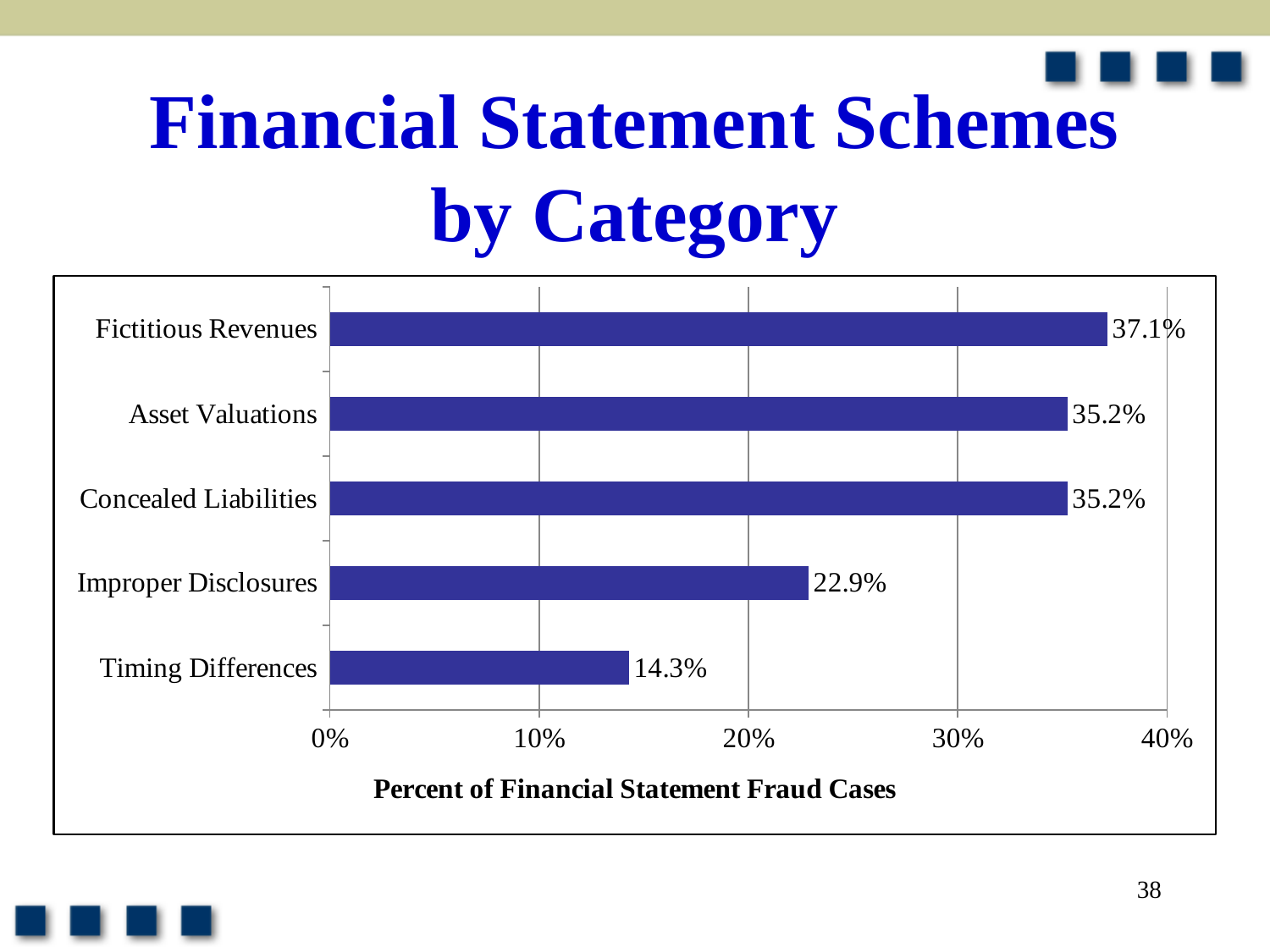
What is the difference between the values for Asset Valuations and Improper Disclosures? 12.3% Which is larger, the value for Improper Disclosures or the value for Timing Differences? Improper Disclosures How many categories are shown in the chart? 5 What percentage of financial statement fraud cases involved Fictitious Revenues? 37.1% What kind of chart is shown on the slide? Bar chart Which category has the highest percentage of financial statement fraud cases? Fictitious Revenues What is the value shown for Concealed Liabilities? 35.2% What is the value shown for Timing Differences? 14.3% Which category has the lowest percentage of financial statement fraud cases? Timing Differences What is the value shown for Improper Disclosures? 22.9% What is the label on the horizontal axis of the chart? Percent of Financial Statement Fraud Cases What is the difference between the values for Fictitious Revenues and Timing Differences? 22.8%